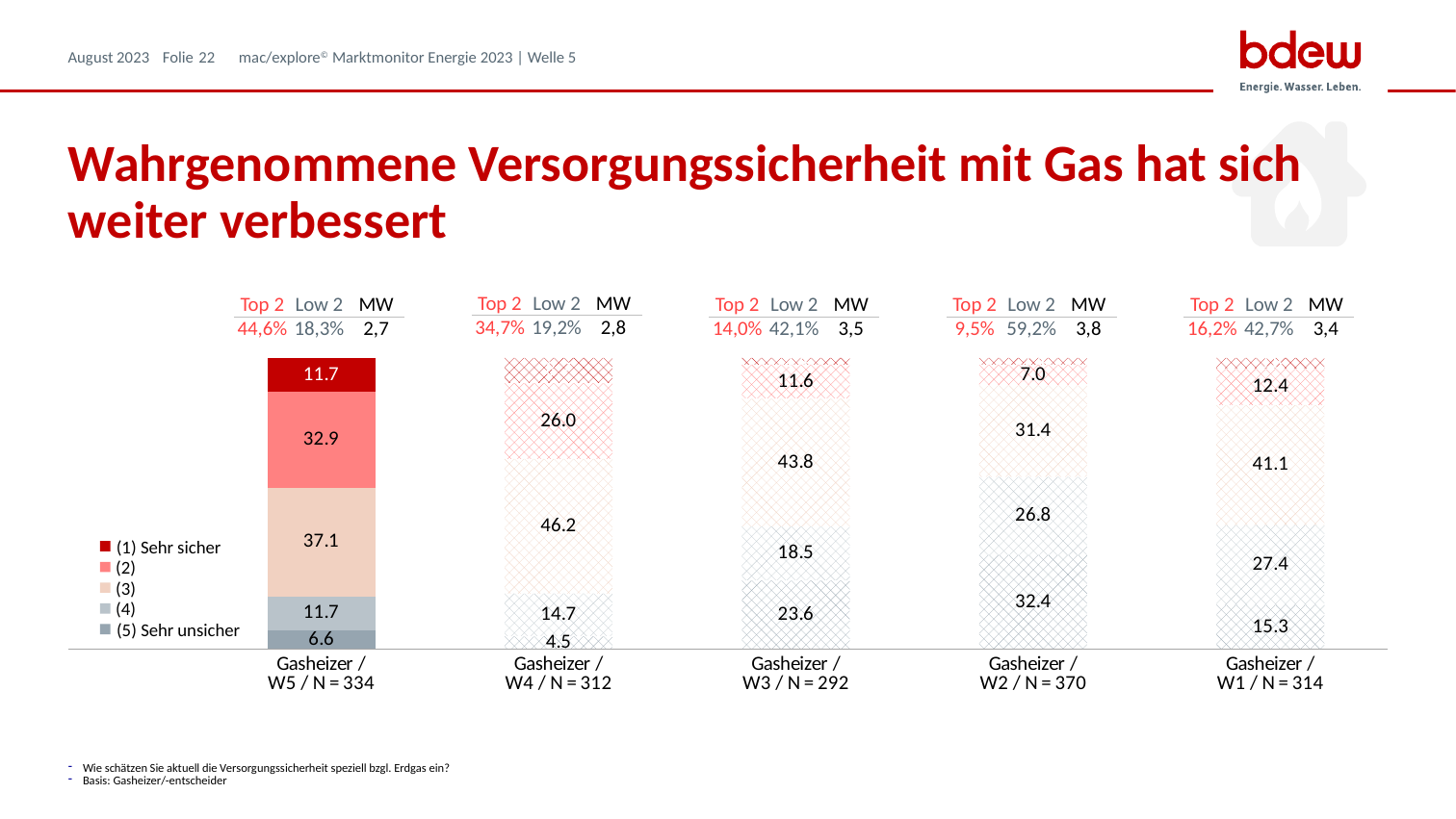
What is the value of the '(1) Sehr sicher' segment for Gasheizer W5 / N = 334? 11.7 How many bars (survey waves) does the chart show? 5 What is the value of the '(5) Sehr unsicher' segment for Gasheizer W2 / N = 370? 32.4 What is the value of the '(4)' segment for Gasheizer W1 / N = 314? 27.4 What is the difference between the '(3)' segment values for W4 and W5? 9.1 Which is larger, the '(5) Sehr unsicher' segment for W3 or for W1? W3 What kind of chart is shown on the slide? stacked bar chart How many series does the legend list? 5 Which wave has the highest Top 2 value? W5 / N = 334 What is the MW value shown above the bar for Gasheizer W2 / N = 370? 3,8 What is the Top 2 value shown above the bar for Gasheizer W5 / N = 334? 44,6% What is the value of the '(3)' segment for Gasheizer W4 / N = 312? 46.2